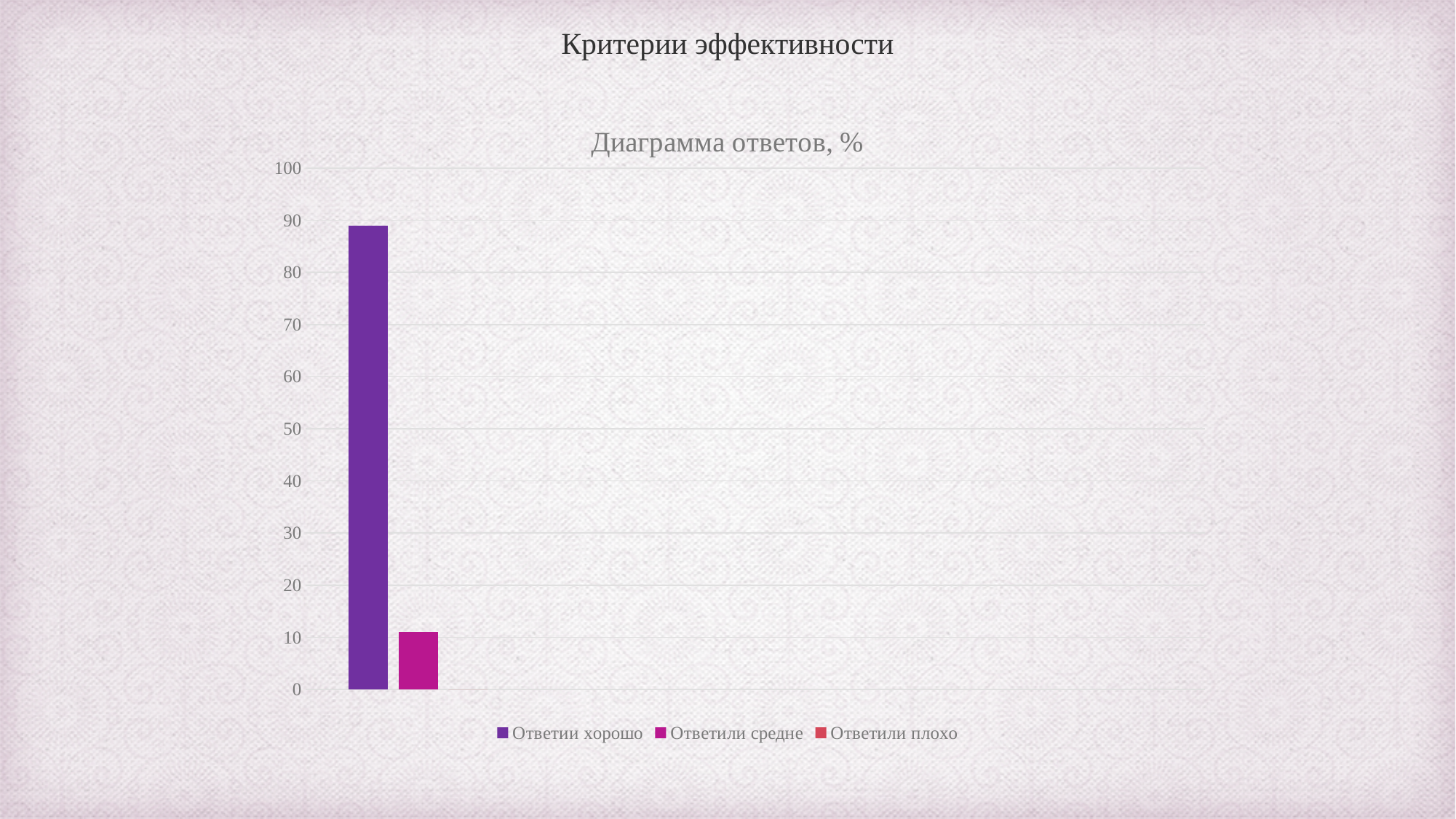
How many series does the legend list? 3 Which is larger, the value for Ответии хорошо or the value for Ответили средне? Ответии хорошо What is the title of the chart? Диаграмма ответов, % Is the value for Ответили средне greater or less than 20? less What is the maximum value shown on the vertical axis? 100 Which series has the highest value in the chart? Ответии хорошо Is the value for Ответии хорошо greater or less than 80? greater What kind of chart is shown on the slide? bar chart